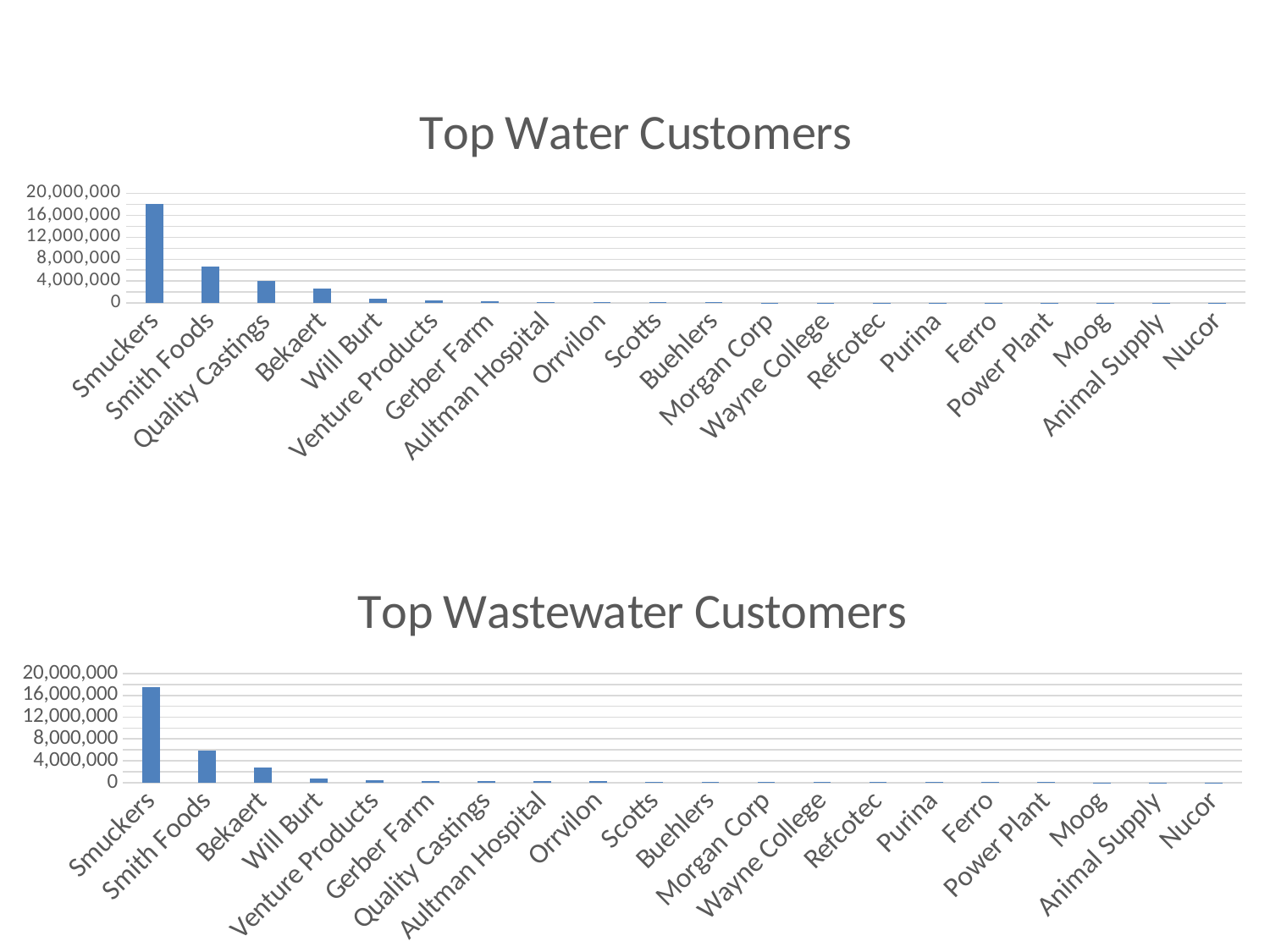
On the Top Water Customers chart, do the values rise or fall from left to right? fall What kind of chart is the Top Water Customers chart? bar chart How many customers are shown on the Top Water Customers chart? 20 How many customers are shown on the Top Wastewater Customers chart? 20 What is the title of the lower chart on the slide? Top Wastewater Customers On the Top Water Customers chart, is the value for Smuckers greater or less than 16,000,000? greater On the Top Water Customers chart, is the value for Smith Foods greater or less than 8,000,000? less On the Top Wastewater Customers chart, is the value for Smith Foods greater or less than 4,000,000? greater On the Top Wastewater Customers chart, which customer has the highest value? Smuckers On the Top Wastewater Customers chart, which is larger, the value for Bekaert or the value for Will Burt? Bekaert On the Top Water Customers chart, which customer has the highest value? Smuckers On the Top Water Customers chart, which is larger, the value for Smith Foods or the value for Bekaert? Smith Foods